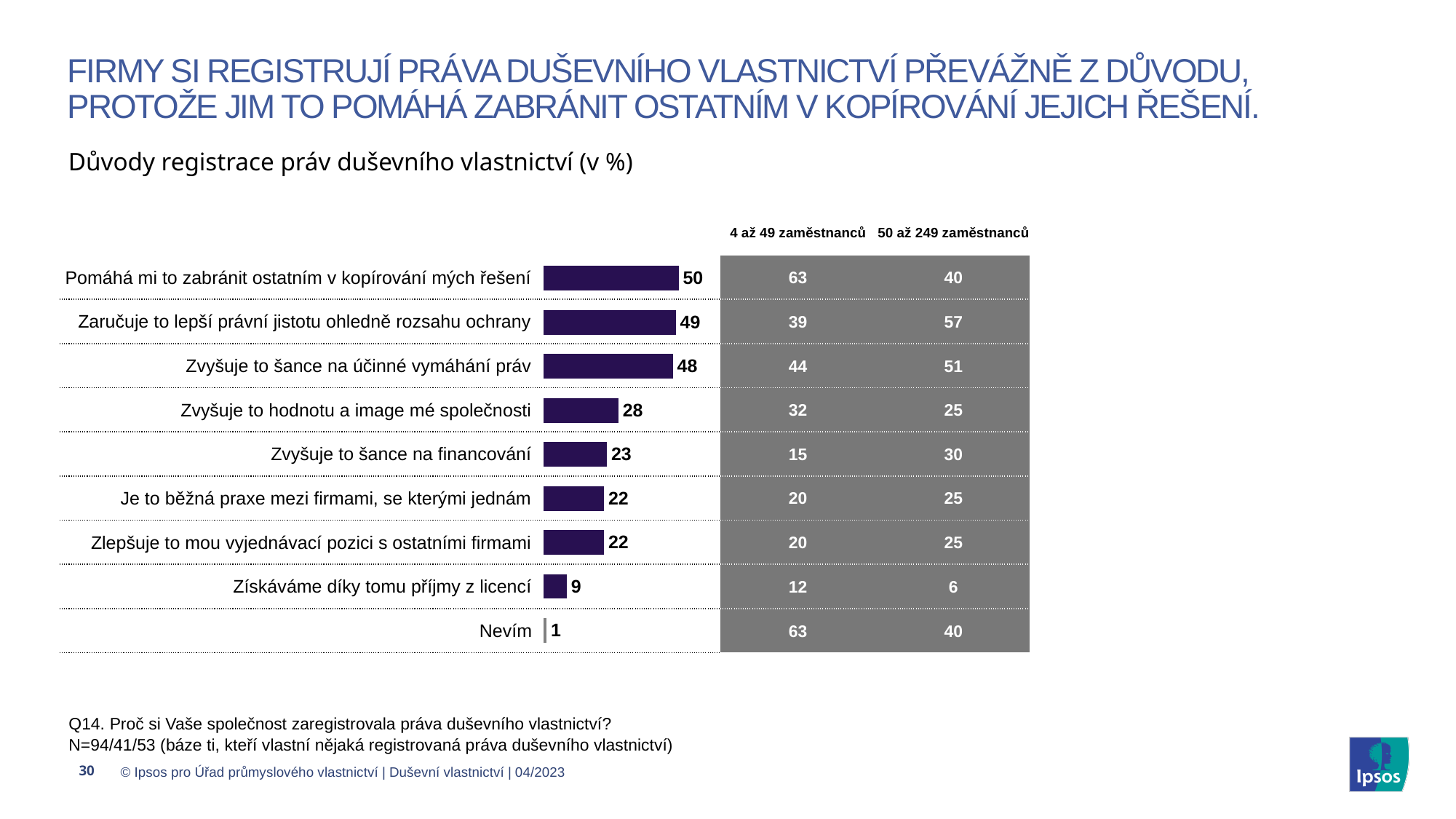
Which category has the highest value in the bar chart? Pomáhá mi to zabránit ostatním v kopírování mých řešení What is the difference between the values for "Zvyšuje to šance na účinné vymáhání práv" and "Zvyšuje to hodnotu a image mé společnosti"? 20 What is the value for "Pomáhá mi to zabránit ostatním v kopírování mých řešení" in the bar chart? 50 How many categories are shown in the bar chart? 9 What is the value for "Získáváme díky tomu příjmy z licencí" in the bar chart? 9 Which category has the lowest value in the bar chart? Nevím What is the value for "Zvyšuje to šance na financování" in the bar chart? 23 Which is larger in the bar chart: "Zaručuje to lepší právní jistotu ohledně rozsahu ochrany" or "Je to běžná praxe mezi firmami, se kterými jednám"? Zaručuje to lepší právní jistotu ohledně rozsahu ochrany What kind of chart is shown on the slide? Bar chart In the table next to the chart, what is the value for "Zaručuje to lepší právní jistotu ohledně rozsahu ochrany" in the "4 až 49 zaměstnanců" column? 39 In the table next to the chart, what is the value for "Zvyšuje to šance na financování" in the "50 až 249 zaměstnanců" column? 30 What is the title of the chart? Důvody registrace práv duševního vlastnictví (v %)